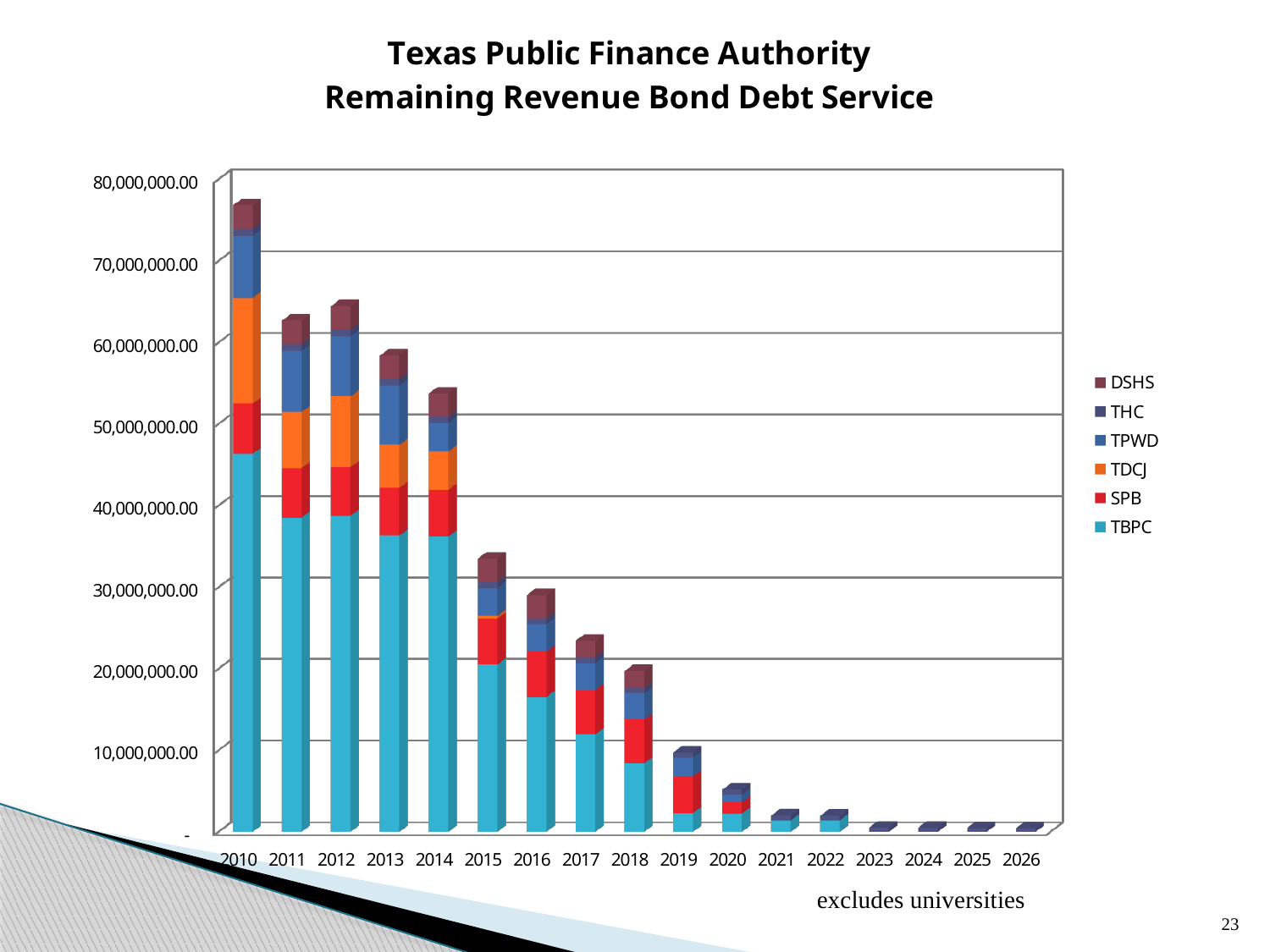
Is the total for 2014 greater or less than 50,000,000.00? greater How many years are shown along the x axis? 17 Is the total for 2015 greater or less than 40,000,000.00? less Is the total for 2010 greater or less than 70,000,000.00? greater Which year has the larger total, 2015 or 2016? 2015 Do the total bar heights generally rise or fall from 2010 to 2026? Fall Which year has the larger total, 2010 or 2014? 2010 Which series is listed last (at the bottom) in the legend? TBPC How many series does the legend list? 6 What kind of chart is shown on the slide? Stacked bar chart Which year has the highest total remaining revenue bond debt service? 2010